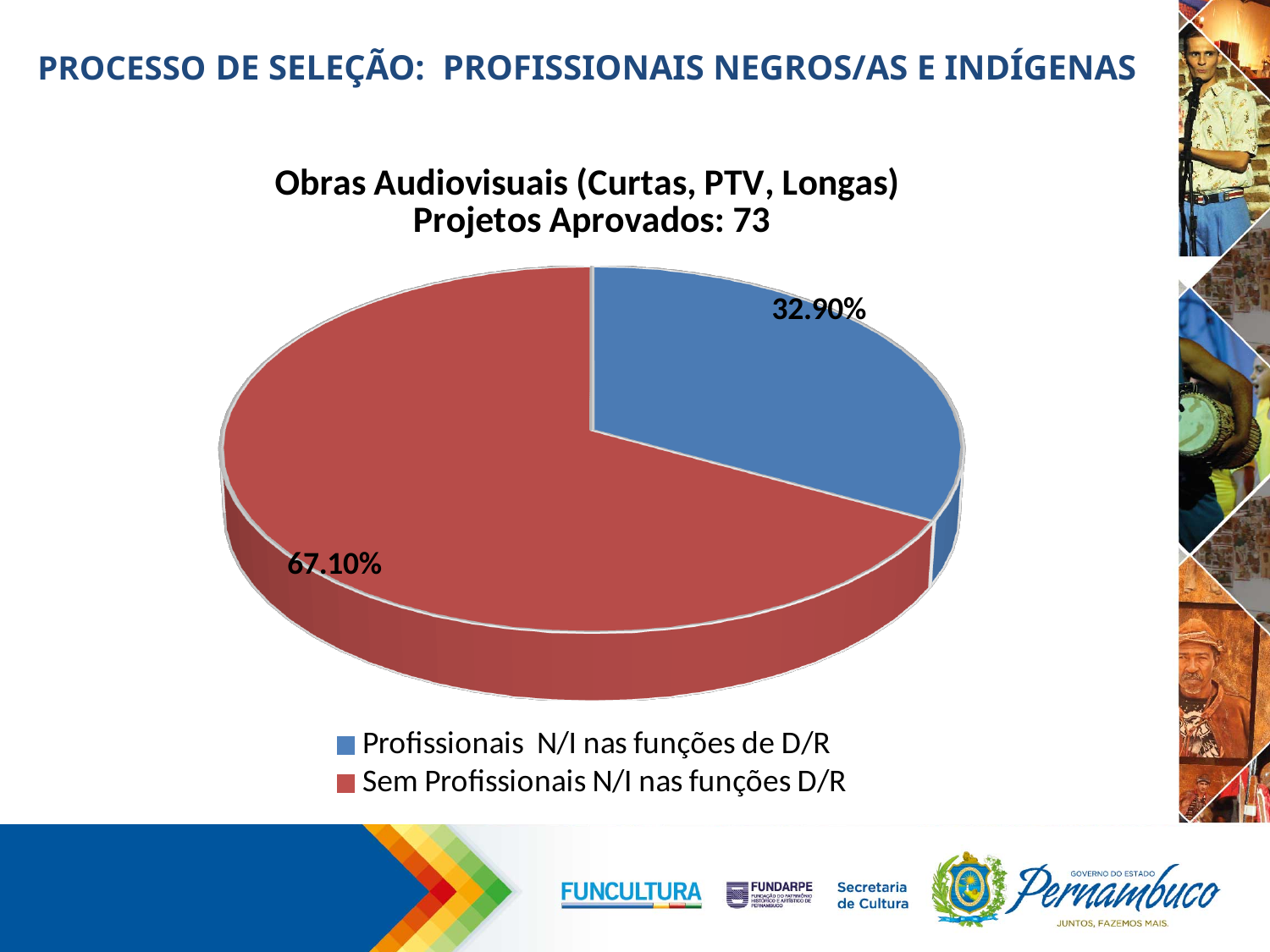
How many approved projects does the chart title state? 73 What is the difference in percentage points between the two slices? 34.20% Which slice is the smallest? Profissionais N/I nas funções de D/R What colour is the slice for "Sem Profissionais N/I nas funções D/R"? red Which slice is the largest? Sem Profissionais N/I nas funções D/R What share of the pie does "Profissionais N/I nas funções de D/R" represent? 32.90% What share of the pie does "Sem Profissionais N/I nas funções D/R" represent? 67.10% Which is larger: the slice for "Profissionais N/I nas funções de D/R" or the slice for "Sem Profissionais N/I nas funções D/R"? Sem Profissionais N/I nas funções D/R How many entries does the legend list? 2 What kind of chart is shown on the slide? pie chart How many slices does the pie chart have? 2 What is the title of the chart? Obras Audiovisuais (Curtas, PTV, Longas) Projetos Aprovados: 73